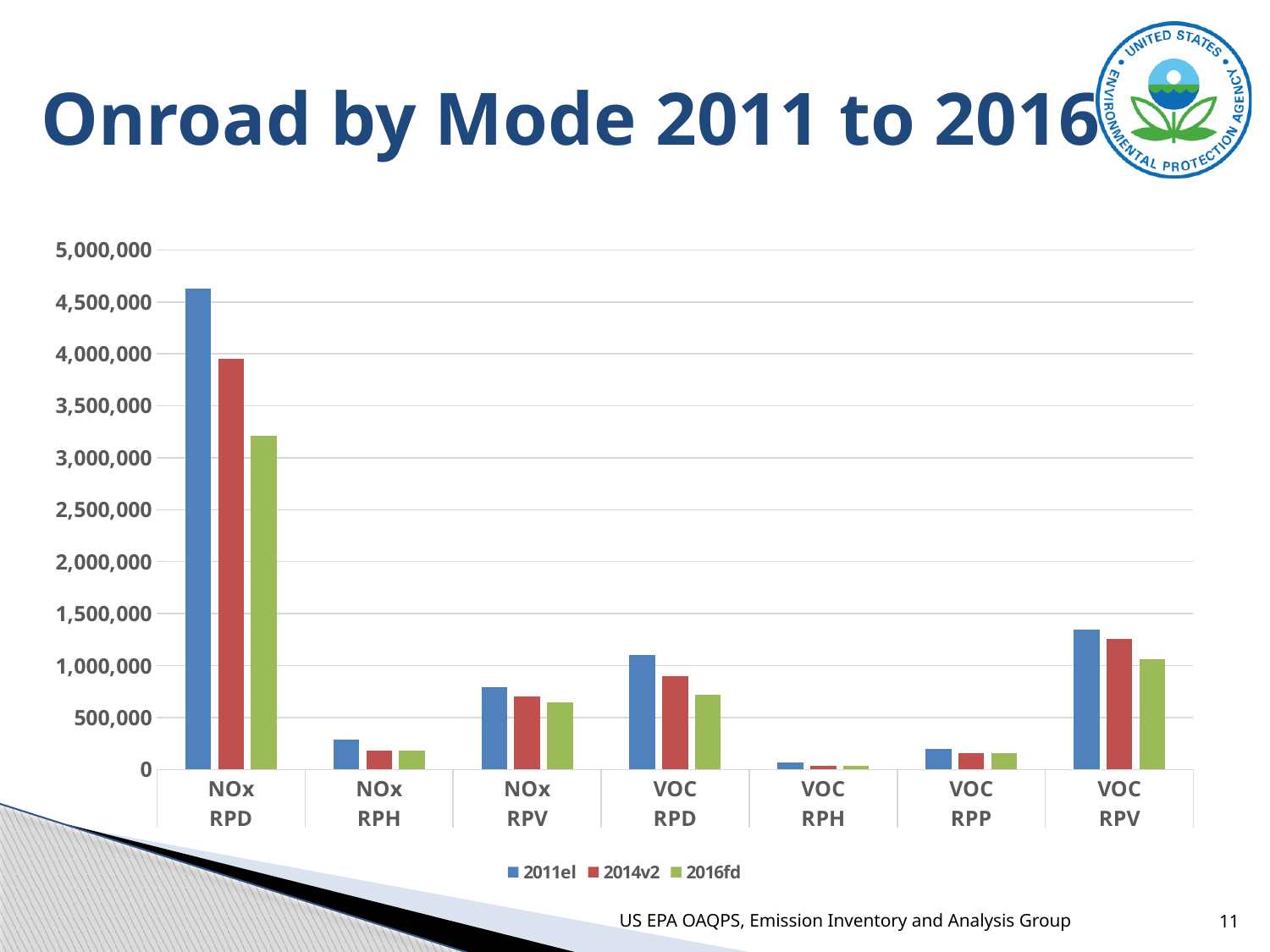
Which category has the highest 2011el value? NOx RPD What are the three legend entries of the chart? 2011el, 2014v2, 2016fd Is the 2011el value for NOx RPD greater or less than 4,500,000? greater What kind of chart is shown on the slide? bar chart Is the 2014v2 value for VOC RPD greater or less than 1,000,000? less How many series does the legend list? 3 Which is larger for 2011el: NOx RPV or VOC RPD? VOC RPD Which is larger for 2011el: VOC RPV or VOC RPD? VOC RPV For NOx RPD, do the values rise or fall from 2011el to 2014v2 to 2016fd? fall Which category has the lowest 2011el value? VOC RPH How many categories are shown on the x axis? 7 Is the 2016fd value for NOx RPD greater or less than 3,500,000? less